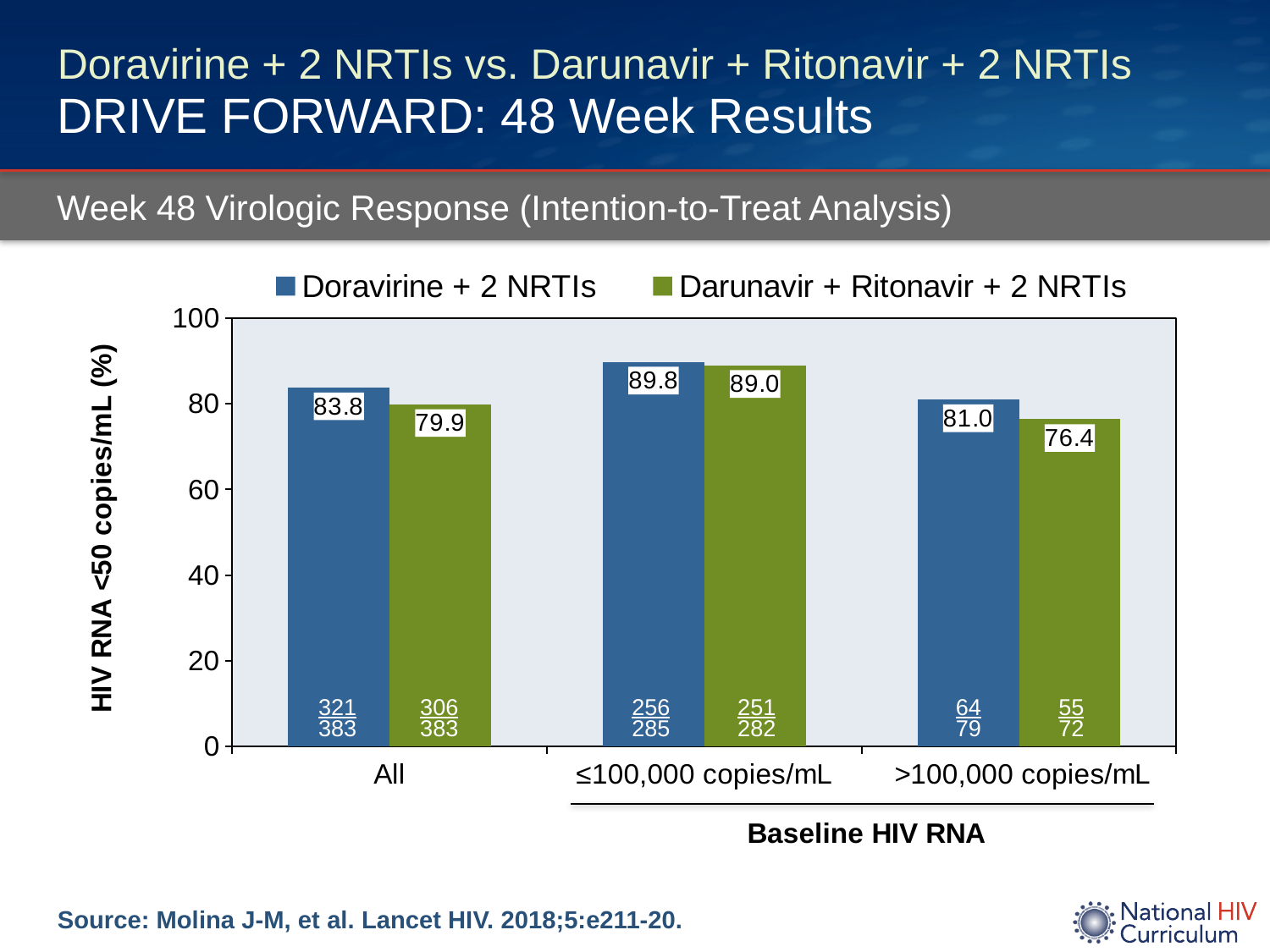
Which is larger in the All category: Doravirine + 2 NRTIs or Darunavir + Ritonavir + 2 NRTIs? Doravirine + 2 NRTIs What is the difference between Doravirine + 2 NRTIs and Darunavir + Ritonavir + 2 NRTIs in the All category? 3.9 What is the value for Darunavir + Ritonavir + 2 NRTIs in the >100,000 copies/mL category? 76.4 What kind of chart is shown on the slide? bar chart Which category has the highest value for Doravirine + 2 NRTIs? ≤100,000 copies/mL What is the difference between Doravirine + 2 NRTIs and Darunavir + Ritonavir + 2 NRTIs in the >100,000 copies/mL category? 4.6 Which category has the lowest value for Darunavir + Ritonavir + 2 NRTIs? >100,000 copies/mL What is the value for Doravirine + 2 NRTIs in the All category? 83.8 How many categories are shown on the x axis? 3 Is the value for Darunavir + Ritonavir + 2 NRTIs in the All category greater or less than 80? less What is the value for Darunavir + Ritonavir + 2 NRTIs in the ≤100,000 copies/mL category? 89.0 How many series does the legend list? 2